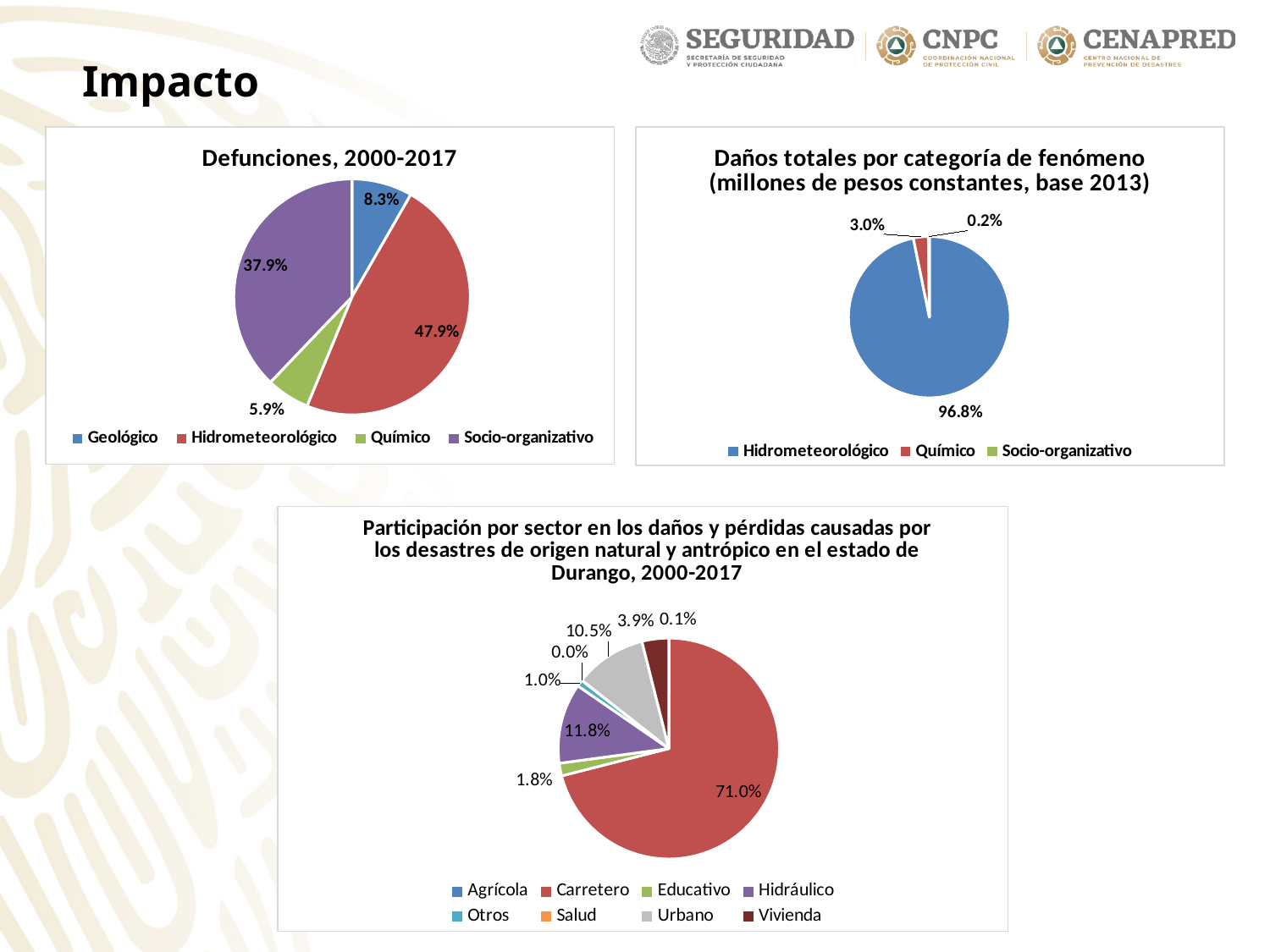
In the bottom chart 'Participación por sector', what is the share for Hidráulico? 11.8% What type of chart is used for 'Participación por sector en los daños y pérdidas' at the bottom of the slide? Pie chart In the 'Daños totales por categoría de fenómeno' chart, which category has the smallest share? Socio-organizativo In the 'Defunciones, 2000-2017' chart, what percentage corresponds to Socio-organizativo? 37.9% In the 'Defunciones, 2000-2017' chart, how many categories does the legend list? 4 In the 'Daños totales por categoría de fenómeno' chart, what share corresponds to Hidrometeorológico? 96.8% In the 'Defunciones, 2000-2017' chart, which category has the smallest share? Químico In the 'Daños totales por categoría de fenómeno' chart, what is the value for Químico? 3.0% In the bottom chart 'Participación por sector', which sector has the largest share? Carretero In the bottom chart 'Participación por sector', which is larger, Urbano or Vivienda? Urbano In the 'Defunciones, 2000-2017' chart, what share of deaths is attributed to Hidrometeorológico phenomena? 47.9% In the 'Defunciones, 2000-2017' chart, what is the difference between the Hidrometeorológico and Socio-organizativo shares? 10.0%